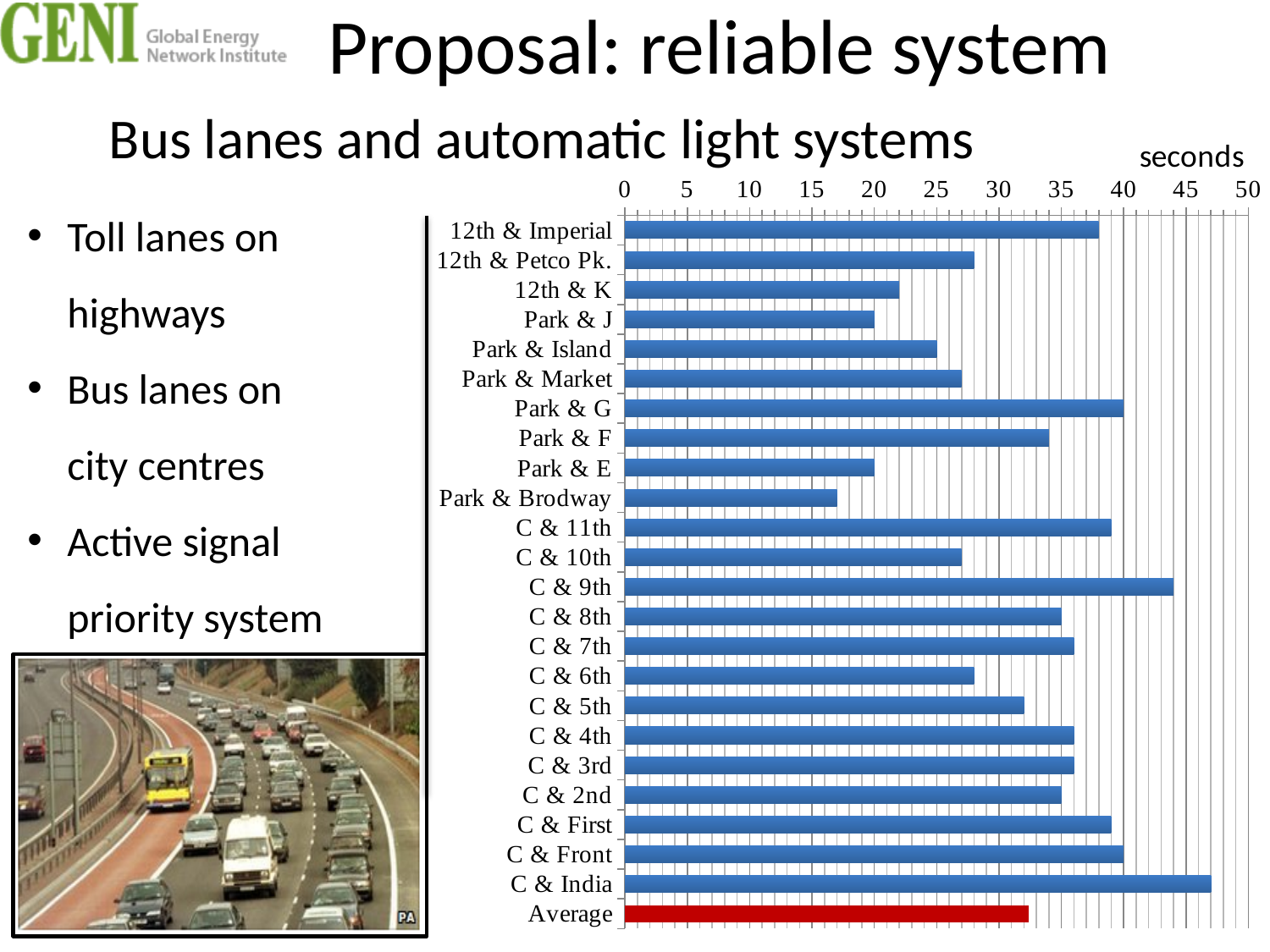
Is the value for 12th & Imperial greater or less than 35? greater Is the value for C & 9th greater or less than 40? greater Is the value for Park & Brodway greater or less than 20? less Which is larger, the value for C & 5th or the value for C & 6th? C & 5th What kind of chart is shown on the slide? bar chart Which bar in the chart is coloured red instead of blue? Average Which is larger, the value for Park & G or the value for Park & F? Park & G Which category has the lowest value in the chart? Park & Brodway Which category has the highest value in the chart? C & India How many categories (bars) are shown in the chart? 24 What unit is shown above the chart's horizontal axis? seconds